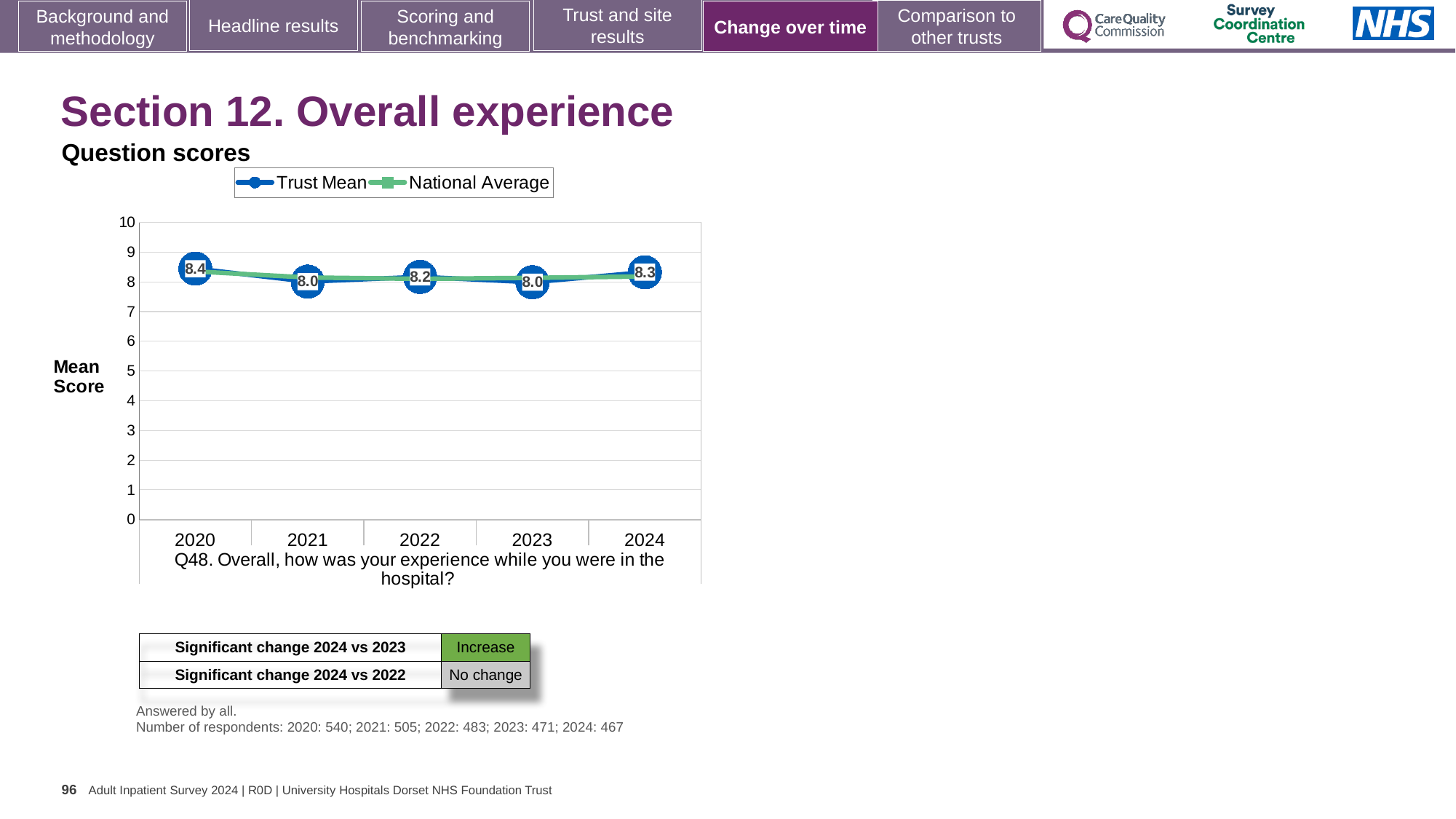
How many series does the legend list? 2 How many years are plotted on the x axis? 5 What is the difference between the Trust Mean scores for 2020 and 2021? 0.4 Is the National Average value for 2020 greater or less than 5? greater What is the Trust Mean score for 2024? 8.3 In which year is the Trust Mean score highest? 2020 What is the label on the y axis of the chart? Mean Score What kind of chart is shown on the slide? line chart What is the Trust Mean score for 2022? 8.2 Does the Trust Mean score rise or fall from 2023 to 2024? rise What is the Trust Mean score for 2020? 8.4 Which year has the larger Trust Mean score, 2022 or 2023? 2022